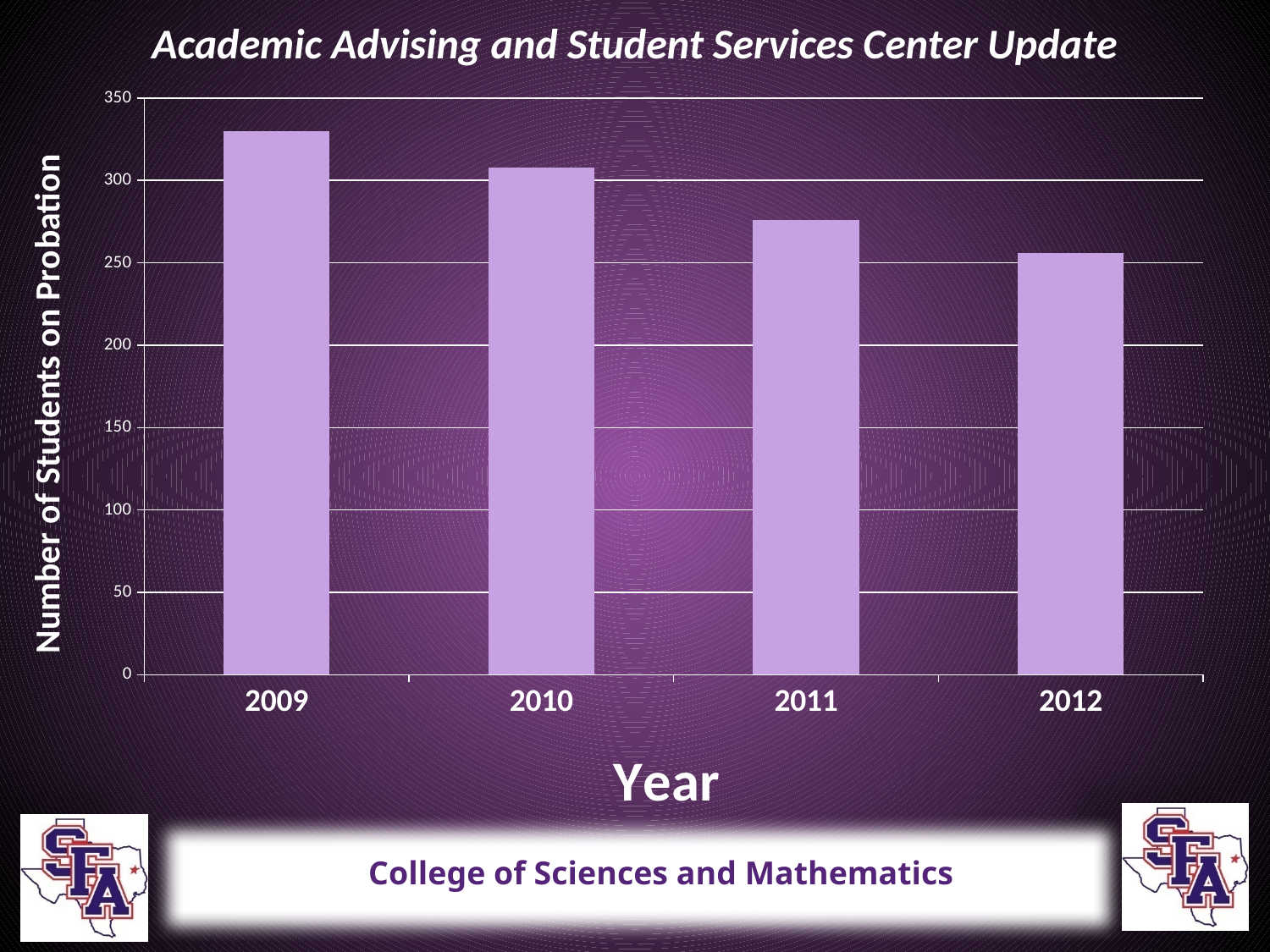
Which year has the lowest number of students on probation? 2012 What is the title of the vertical axis of the chart? Number of Students on Probation Which year has more students on probation, 2009 or 2012? 2009 Is the number of students on probation in 2009 greater or less than 300? greater Is the number of students on probation in 2011 greater or less than 250? greater Is the number of students on probation in 2012 greater or less than 300? less How many years are shown on the x axis of the chart? 4 What kind of chart is shown on the slide? bar chart Do the number of students on probation rise or fall from 2009 to 2012? fall Which year has the highest number of students on probation? 2009 What is the title of the horizontal axis of the chart? Year